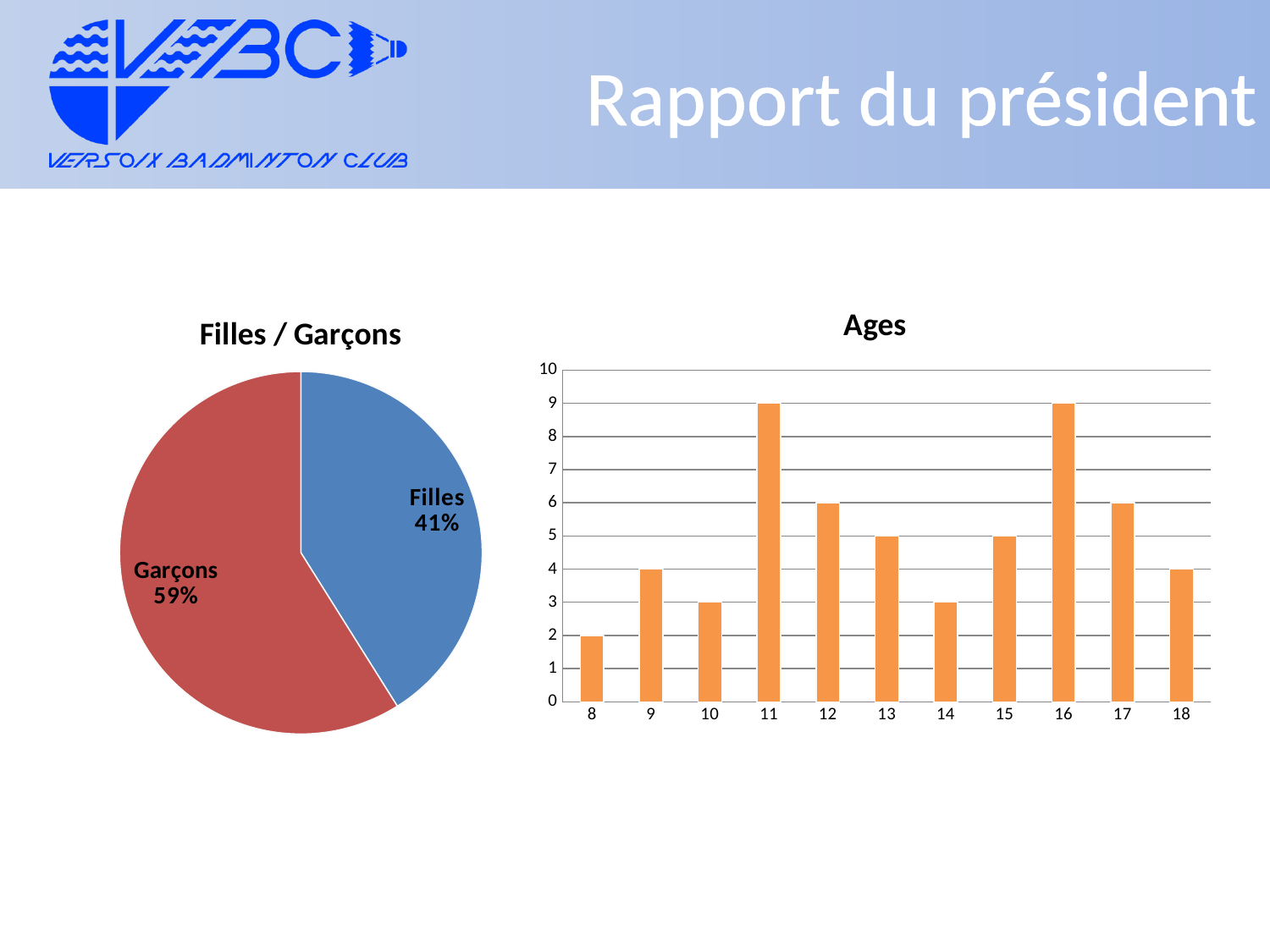
In the 'Filles / Garçons' chart, which slice is larger, Filles or Garçons? Garçons In the 'Filles / Garçons' pie chart, what share is Garçons? 59% In the 'Ages' chart, what is the value for age 8? 2 In the 'Ages' chart, what is the difference between the values for age 16 and age 14? 6 In the 'Ages' chart, what is the value for age 11? 9 In the 'Filles / Garçons' pie chart, what share is Filles? 41% What kind of chart is the 'Ages' chart? bar chart In the 'Ages' chart, which age has the lowest value? 8 In the 'Ages' chart, how many age categories are shown on the x axis? 11 In the 'Ages' chart, which is larger, the value for age 12 or the value for age 13? age 12 In the 'Ages' chart, is the value for age 17 greater or less than 5? greater What kind of chart is the 'Filles / Garçons' chart? pie chart